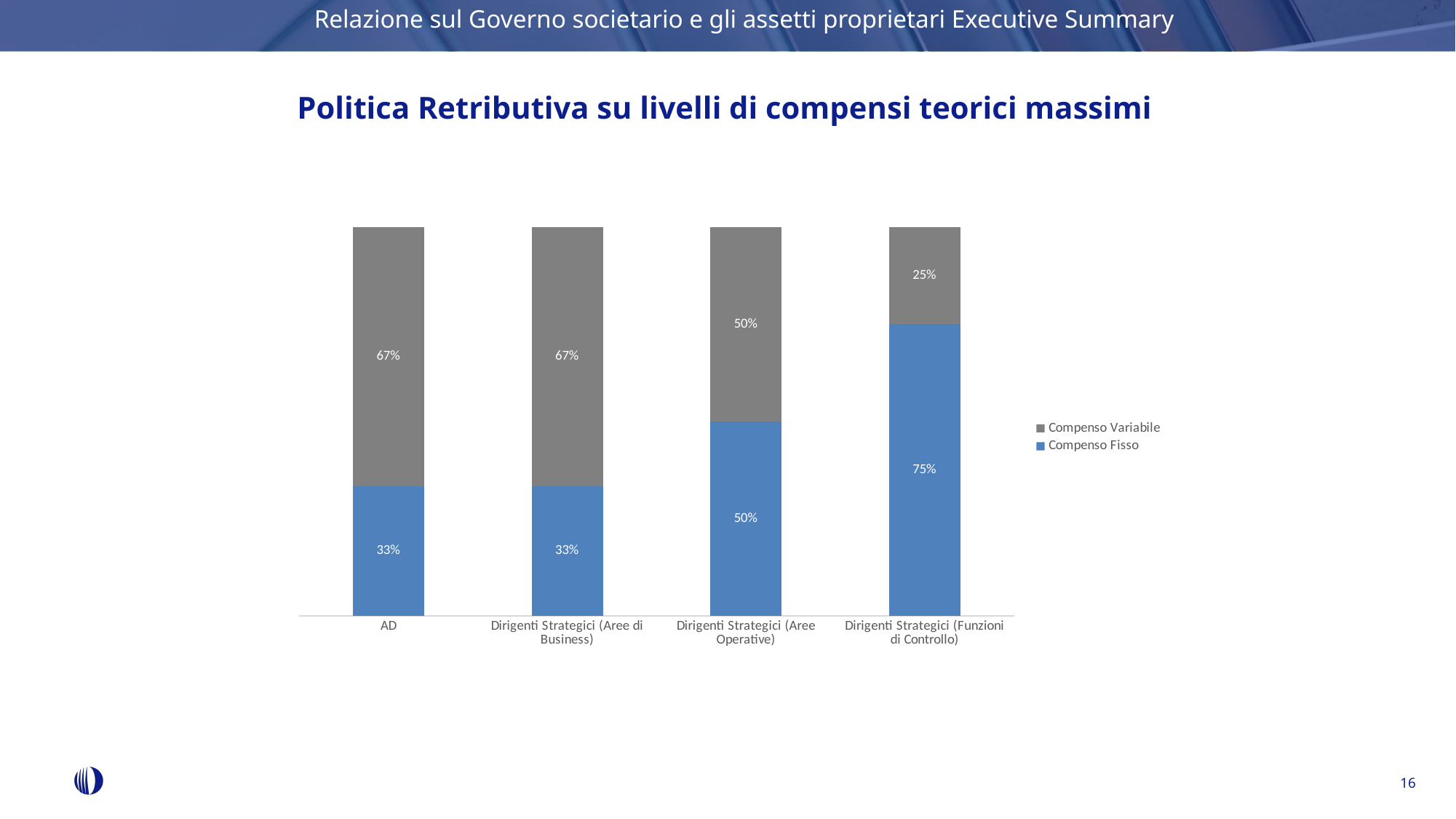
What is the Compenso Fisso value for Dirigenti Strategici (Aree Operative)? 50% What is the Compenso Variabile value for Dirigenti Strategici (Funzioni di Controllo)? 25% Which is larger for Dirigenti Strategici (Aree di Business): Compenso Fisso or Compenso Variabile? Compenso Variabile What is the difference between the Compenso Fisso values for Dirigenti Strategici (Funzioni di Controllo) and AD? 42% What is the Compenso Variabile value for Dirigenti Strategici (Aree di Business)? 67% What is the Compenso Fisso value for AD? 33% Which category has the lowest Compenso Variabile value? Dirigenti Strategici (Funzioni di Controllo) What kind of chart is shown on the slide? Stacked bar chart How many series does the legend list? 2 What is the title of the chart? Politica Retributiva su livelli di compensi teorici massimi Which category has the highest Compenso Fisso value? Dirigenti Strategici (Funzioni di Controllo) How many categories are shown on the x axis? 4